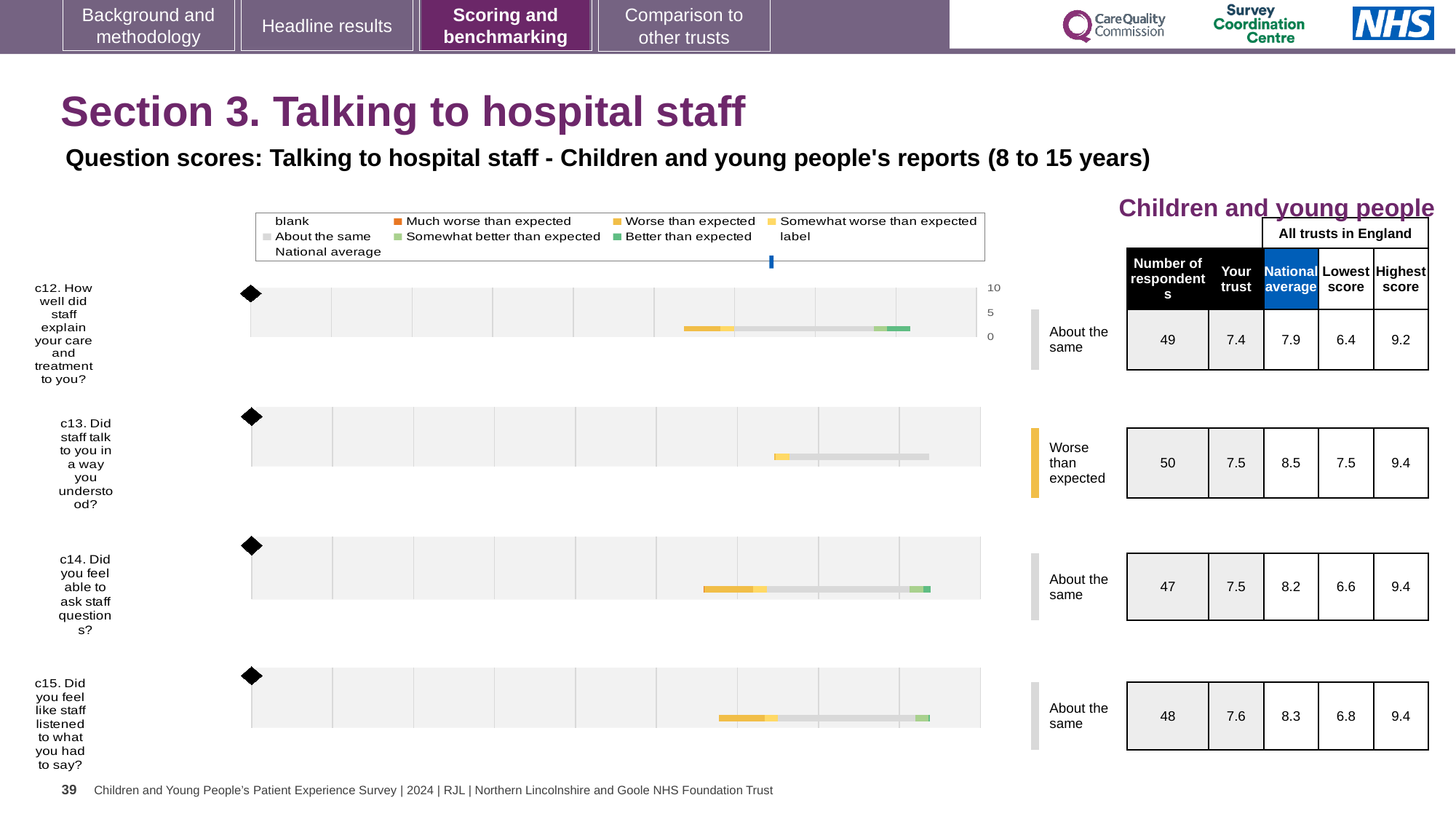
What benchmark category is shown for question c13 (Did staff talk to you in a way you understood?)? Worse than expected How many of the questions are rated 'About the same'? 3 What is the national average score for question c13 (Did staff talk to you in a way you understood?)? 8.5 For question c14, is the 'Your trust' score higher or lower than the national average? lower What is the 'Your trust' score for question c15 (Did you feel like staff listened to what you had to say?)? 7.6 Which question has the lowest 'Your trust' score? c12. How well did staff explain your care and treatment to you? How many respondents answered question c12 (How well did staff explain your care and treatment to you?)? 49 What is the lowest score across all trusts in England for question c12? 6.4 What kind of chart is used to show the question scores? bar chart For question c13, what is the difference between the national average and the 'Your trust' score? 1.0 Which question has the highest national average score? c13. Did staff talk to you in a way you understood? How many questions are shown on the slide? 4